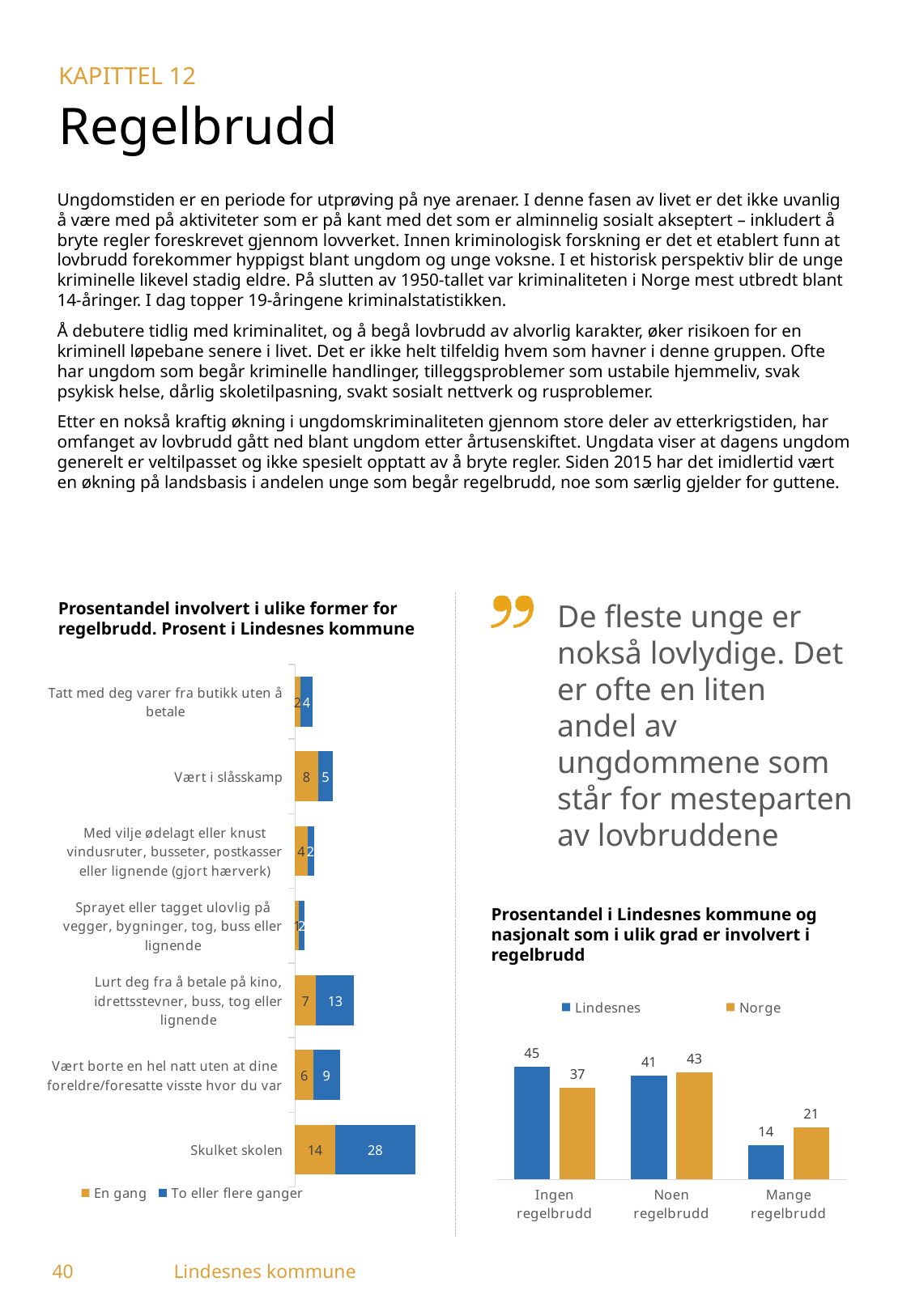
In the chart 'Prosentandel i Lindesnes kommune og nasjonalt', which is larger for 'Mange regelbrudd', Lindesnes or Norge? Norge In the chart 'Prosentandel i Lindesnes kommune og nasjonalt', what is the value for Norge for 'Mange regelbrudd'? 21 In the chart 'Prosentandel involvert i ulike former for regelbrudd', how many categories are shown? 7 In the chart 'Prosentandel involvert i ulike former for regelbrudd', what is the value for 'En gang' for 'Vært i slåsskamp'? 8 In the chart 'Prosentandel i Lindesnes kommune og nasjonalt', what is the difference between Lindesnes and Norge for 'Ingen regelbrudd'? 8 What kind of chart is 'Prosentandel involvert i ulike former for regelbrudd'? Stacked bar chart In the chart 'Prosentandel involvert i ulike former for regelbrudd', what is the value for 'To eller flere ganger' for 'Skulket skolen'? 28 In the chart 'Prosentandel i Lindesnes kommune og nasjonalt', what is the value for Lindesnes for 'Ingen regelbrudd'? 45 In the chart 'Prosentandel involvert i ulike former for regelbrudd', how many series does the legend list? 2 In the chart 'Prosentandel involvert i ulike former for regelbrudd', what is the total of the stacked bar for 'Lurt deg fra å betale på kino, idrettsstevner, buss, tog eller lignende'? 20 In the chart 'Prosentandel i Lindesnes kommune og nasjonalt', which category has the lowest value for Lindesnes? Mange regelbrudd In the chart 'Prosentandel involvert i ulike former for regelbrudd', what is the total of the stacked bar for 'Skulket skolen'? 42